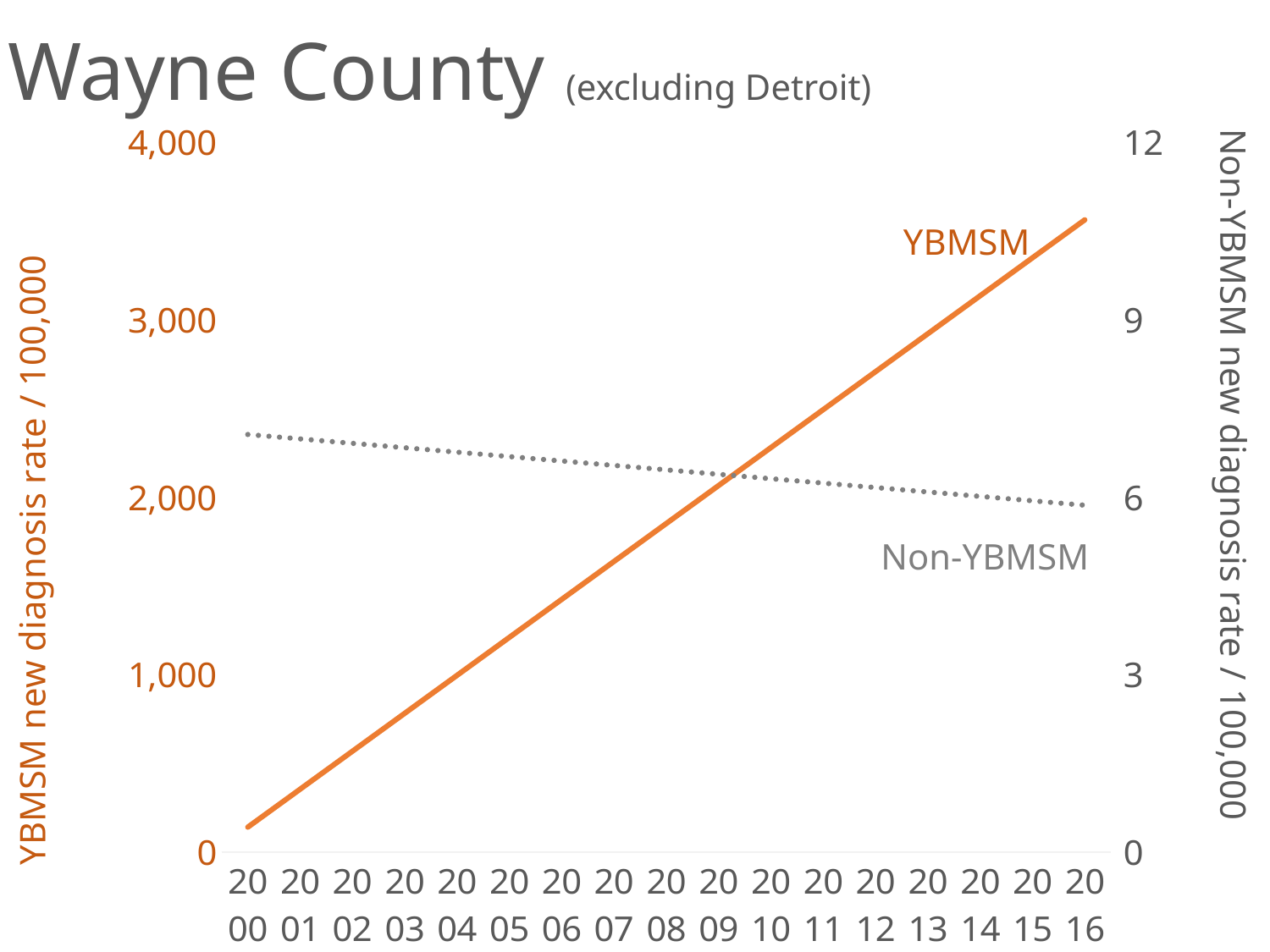
In which year is the Non-YBMSM new diagnosis rate highest? 2000 What is the title of the chart? Wayne County (excluding Detroit) Is the Non-YBMSM new diagnosis rate in 2000 greater or less than 6? greater How many series are plotted on the chart? 2 In which year is the YBMSM new diagnosis rate highest? 2016 Is the YBMSM new diagnosis rate in 2016 greater or less than 3,000? greater In which year is the YBMSM new diagnosis rate lowest? 2000 Is the YBMSM new diagnosis rate in 2000 greater or less than 1,000? less What kind of chart is shown on the slide? line chart Does the Non-YBMSM new diagnosis rate rise or fall from 2000 to 2016? fall How many years are shown along the x axis? 17 Does the YBMSM new diagnosis rate rise or fall from 2000 to 2016? rise